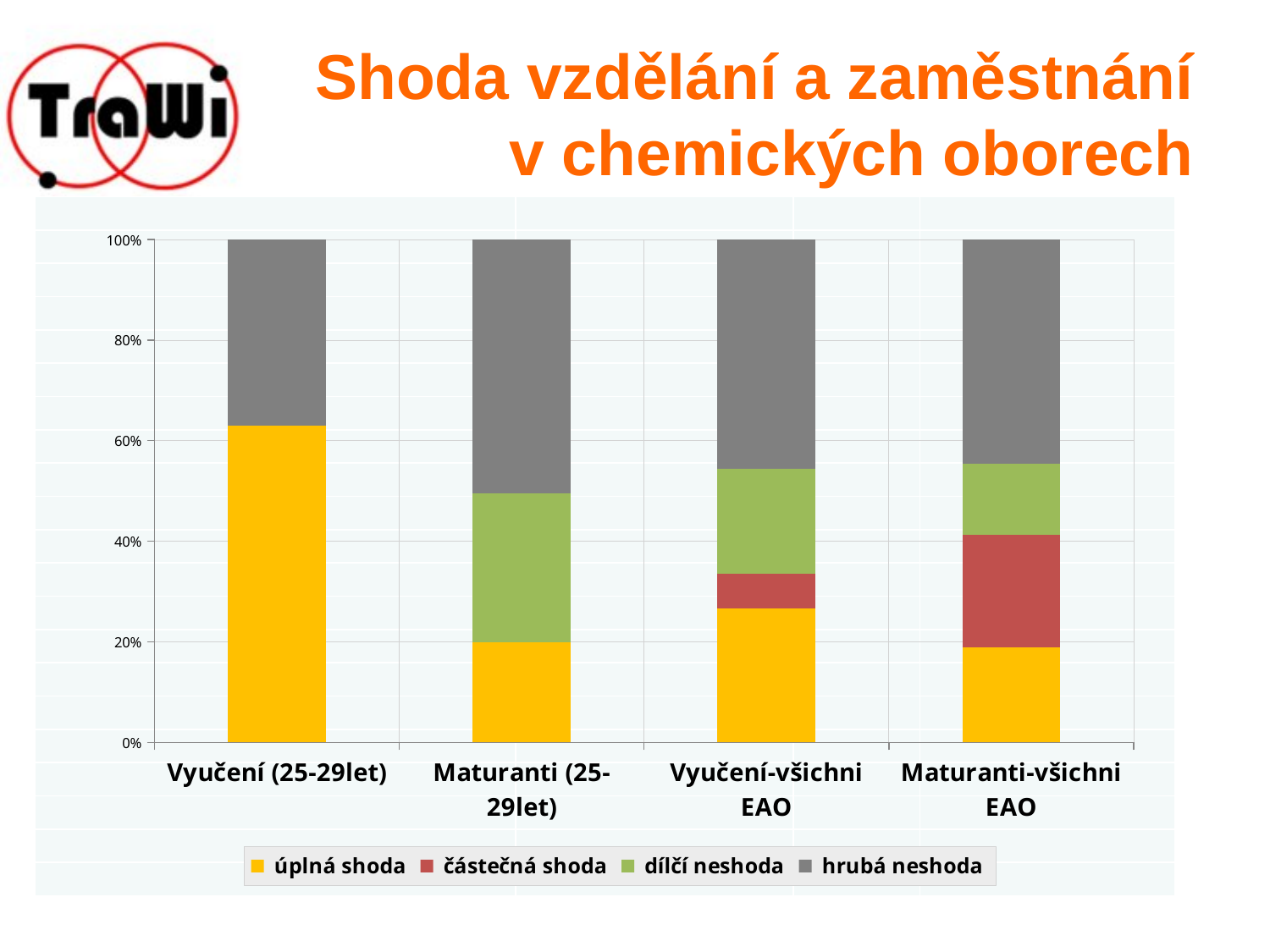
Is the úplná shoda value for Vyučení (25-29let) greater or less than 60%? greater Which category has the highest share of úplná shoda? Vyučení (25-29let) Is the úplná shoda value for Maturanti (25-29let) greater or less than 40%? less How many categories are shown on the x axis of the chart? 4 Which is larger: the úplná shoda share for Vyučení (25-29let) or for Maturanti (25-29let)? Vyučení (25-29let) Which series is shown in grey in the chart's legend? hrubá neshoda What is the title of the slide containing the chart? Shoda vzdělání a zaměstnání v chemických oborech What is the total of the stacked bar for Vyučení (25-29let)? 100% How many series does the chart's legend list? 4 Is the úplná shoda value for Vyučení-všichni EAO greater or less than 20%? greater Which is larger: the částečná shoda share for Maturanti-všichni EAO or for Vyučení-všichni EAO? Maturanti-všichni EAO What kind of chart is shown on the slide? stacked bar chart